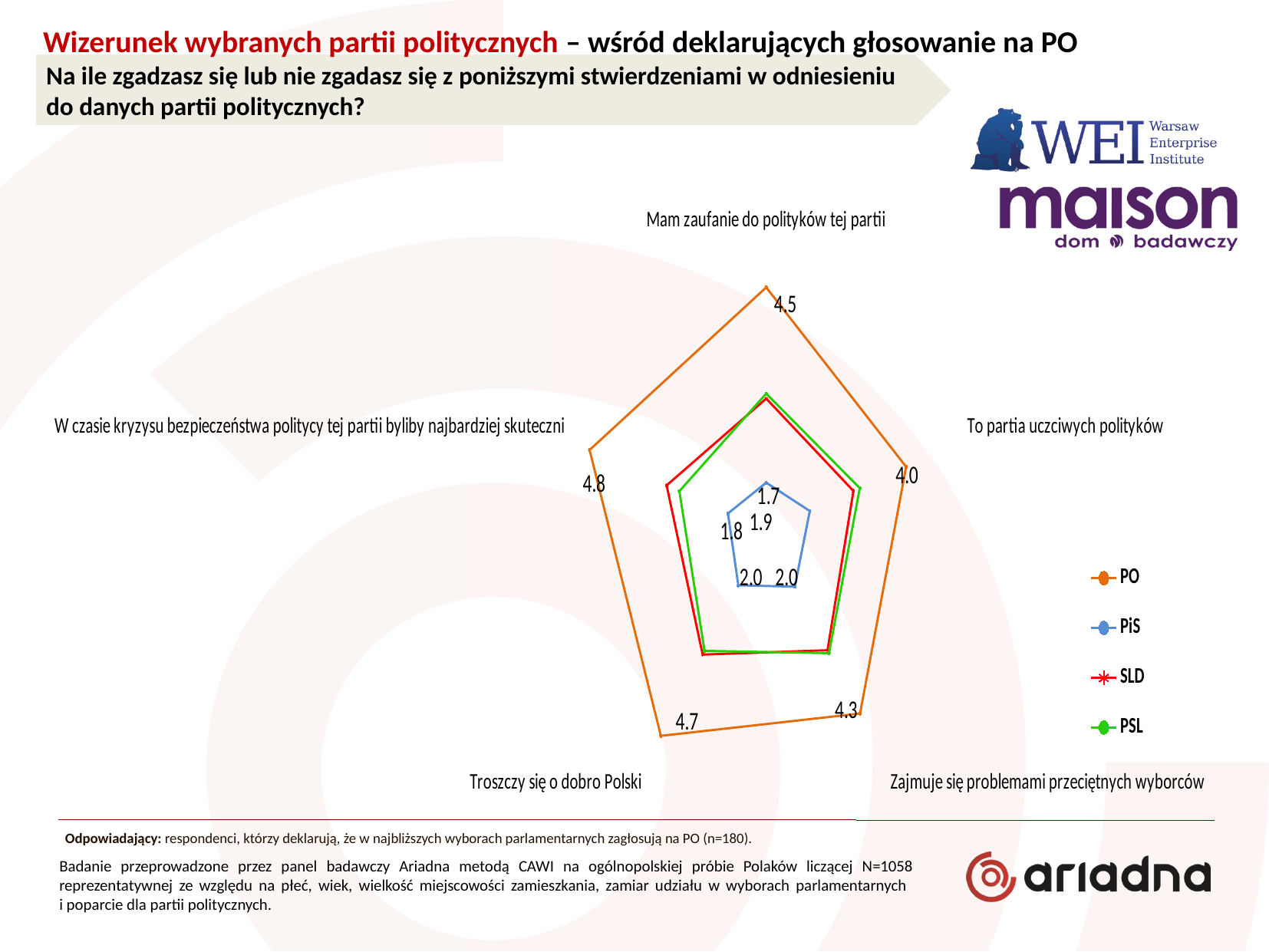
Which party has the larger value for 'Troszczy się o dobro Polski', PO or PiS? PO What is the value for PO on the statement 'To partia uczciwych polityków'? 4.0 What is the value for PiS on the statement 'Mam zaufanie do polityków tej partii'? 1.7 On which statement does PO have its lowest value? To partia uczciwych polityków What kind of chart is shown on the slide? Radar chart What is the value for PO on the statement 'Mam zaufanie do polityków tej partii'? 4.5 How many series does the legend list? 4 What is the value for PO on the statement 'W czasie kryzysu bezpieczeństwa politycy tej partii byliby najbardziej skuteczni'? 4.8 What is the difference between PO's values for 'Troszczy się o dobro Polski' and 'Zajmuje się problemami przeciętnych wyborców'? 0.4 On which statement does PO have its highest value? W czasie kryzysu bezpieczeństwa politycy tej partii byliby najbardziej skuteczni Which colour represents PSL in the legend? Green How many statements (categories) are plotted on the radar chart? 5